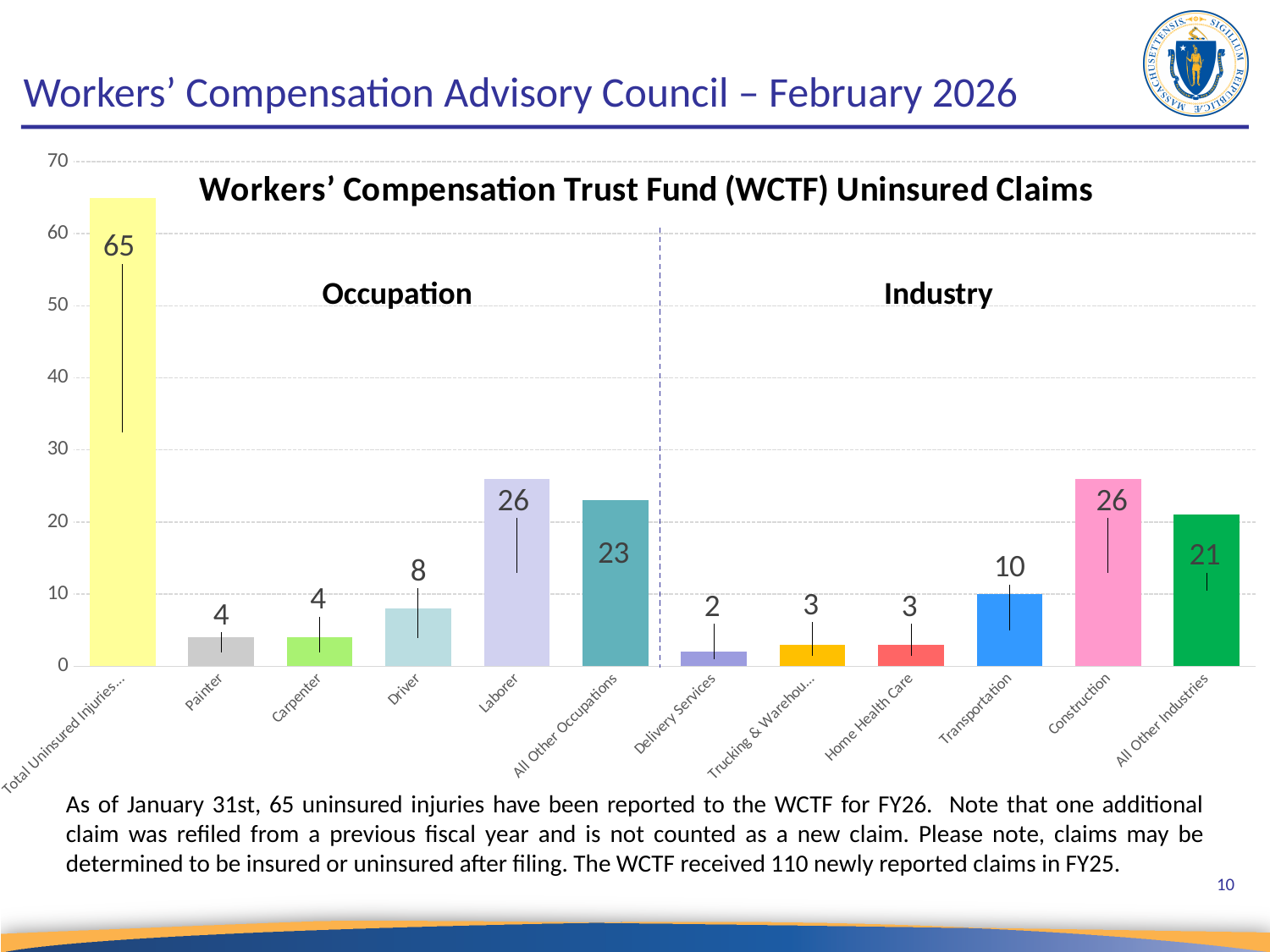
What is the difference between the values for Construction and All Other Industries? 5 What is the value for Transportation? 10 What is the value for Driver? 8 Which category has the lowest value? Delivery Services What kind of chart is shown on the slide? bar chart How many categories are shown on the x axis? 12 What is the value for Delivery Services? 2 Which category has the highest value? Total Uninsured Injuries What is the title of the chart? Workers' Compensation Trust Fund (WCTF) Uninsured Claims Which is larger, the value for Laborer or the value for All Other Occupations? Laborer Is the value for Home Health Care greater or less than 10? less What is the value for Laborer? 26